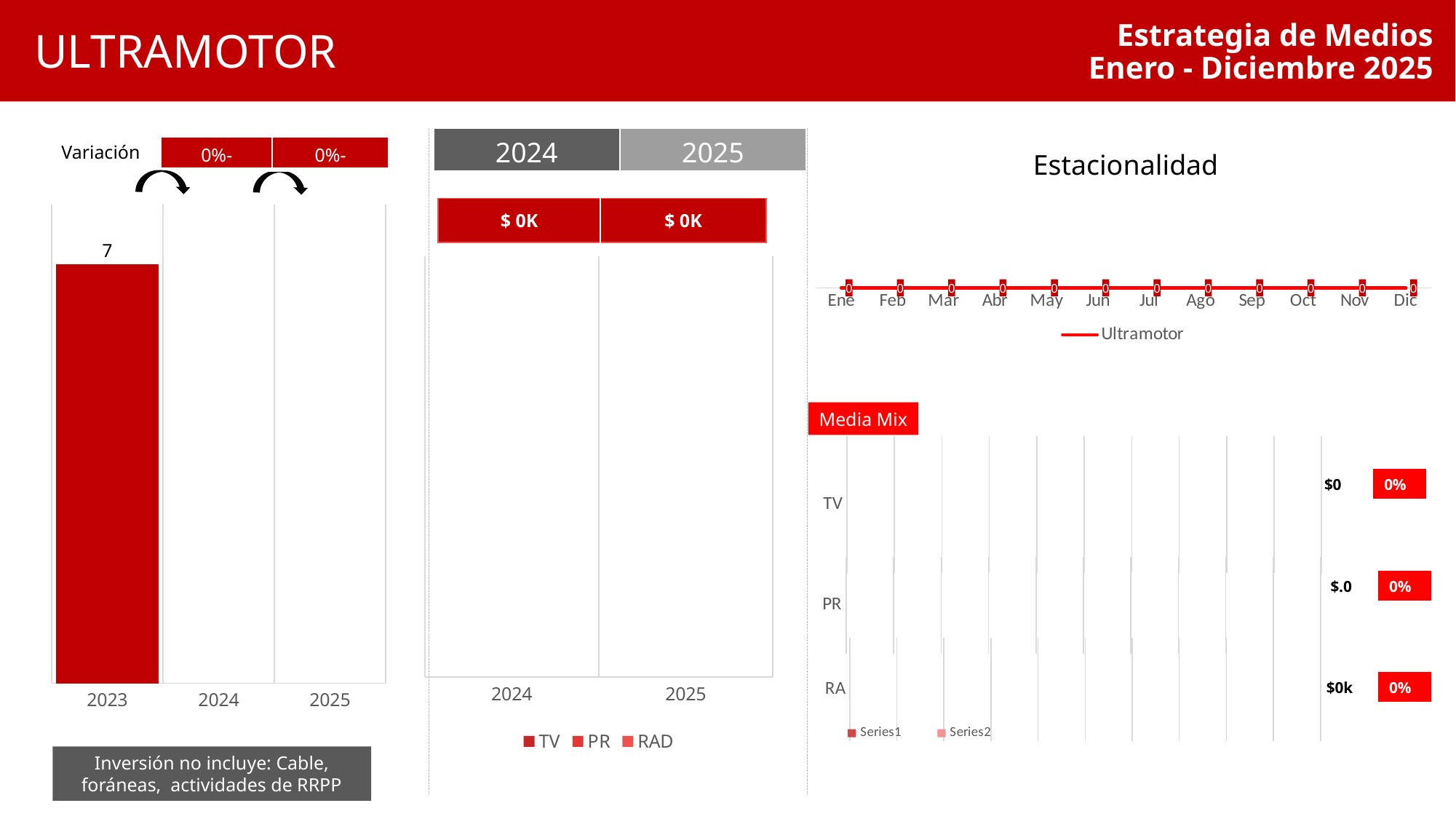
On the Media Mix chart, what percentage is shown for TV? 0% On the Estacionalidad chart, how many series does the legend list? 1 On the middle chart with years 2024 and 2025, what are the legend entries? TV, PR, RAD On the middle chart, what value is shown in the red box above 2024? $ 0K On the left bar chart, how many year categories are shown on the x axis? 3 On the left bar chart, which year has the highest bar? 2023 On the middle chart with years 2024 and 2025, how many series does the legend list? 3 On the left bar chart, what is the value for 2023? 7 What is the title of the line chart in the upper right? Estacionalidad On the Estacionalidad chart, how many months are shown on the x axis? 12 What kind of chart is the left chart with years 2023, 2024 and 2025? bar chart On the Estacionalidad chart, what is the value for Jul? 0